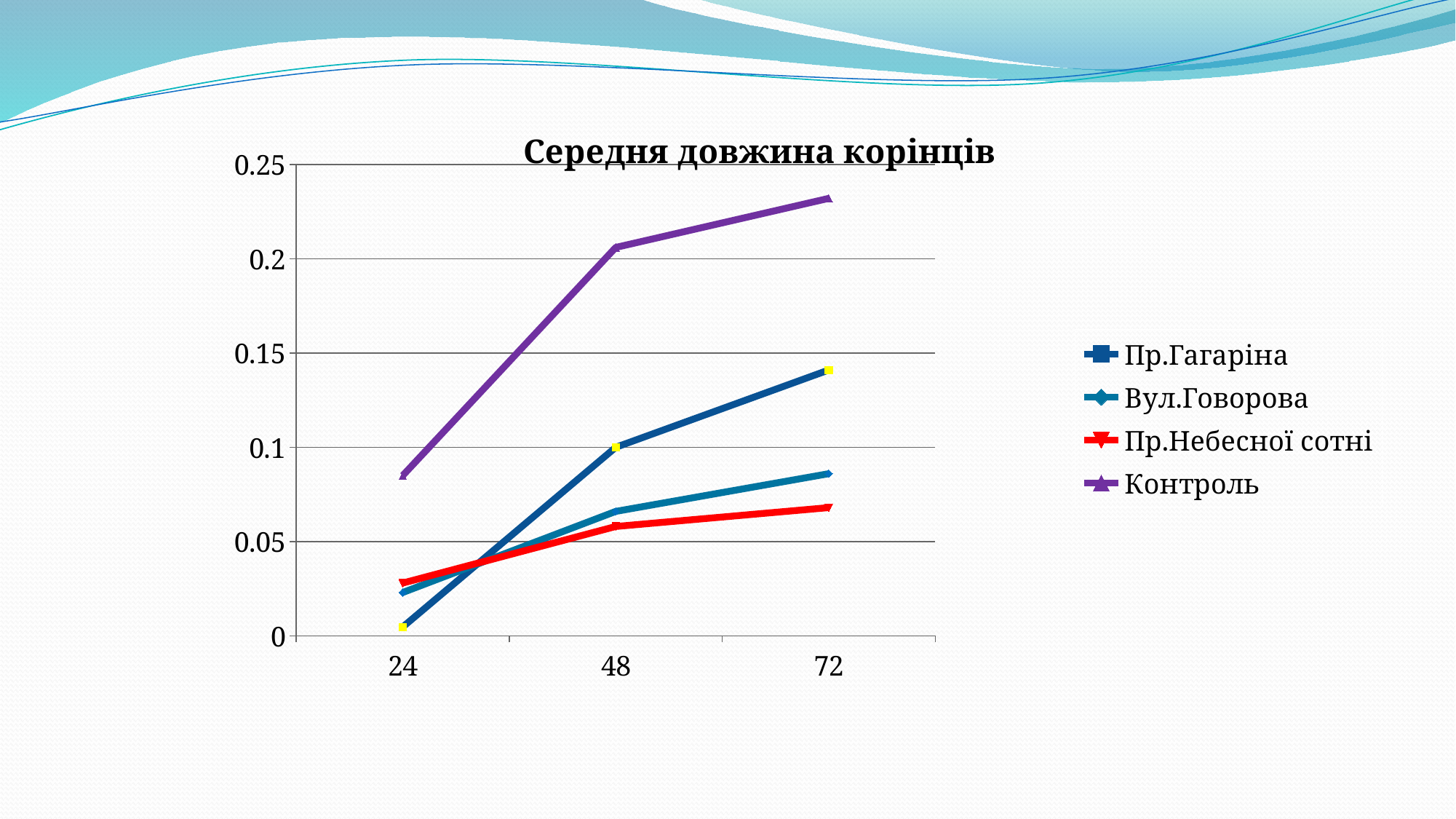
Which series has the lowest value at 24? Пр.Гагаріна Is the value for Контроль at 48 greater or less than 0.2? greater Do the values for Контроль rise or fall from 24 to 72? rise Which series has the highest value at 72? Контроль What is the title of the chart? Середня довжина корінців How many points are plotted along the x axis for each series? 3 Which series is drawn in red? Пр.Небесної сотні Which is larger at 72: Пр.Гагаріна or Вул.Говорова? Пр.Гагаріна What kind of chart is shown on the slide? line chart Is the value for Вул.Говорова at 72 greater or less than 0.1? less Is the value for Пр.Небесної сотні at 48 greater or less than 0.05? greater How many series does the legend list? 4